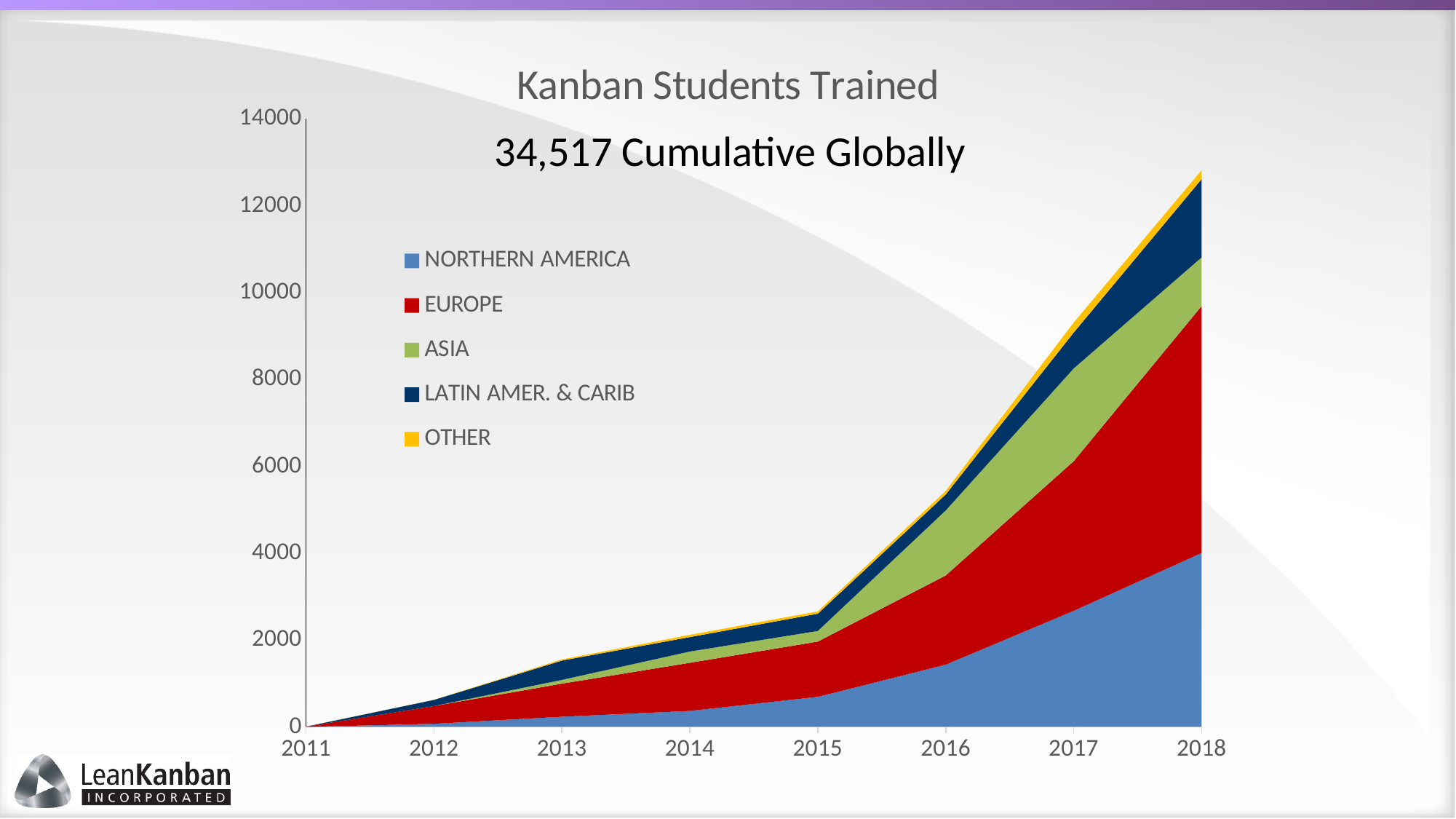
How many years are shown along the x axis? 8 Is the total stacked value for 2015 greater or less than 4000? less Is the total stacked value for 2018 greater or less than 12000? greater In which year is the total stacked value lowest? 2011 Which series has the larger value in 2018, EUROPE or OTHER? EUROPE Is the total stacked value for 2017 greater or less than 8000? greater What cumulative global figure is printed on the chart? 34,517 How many series does the legend list? 5 What is the title of the chart? Kanban Students Trained In which year is the total stacked value highest? 2018 Do the total values rise or fall from 2011 to 2018? Rise What kind of chart is shown on the slide? Area chart